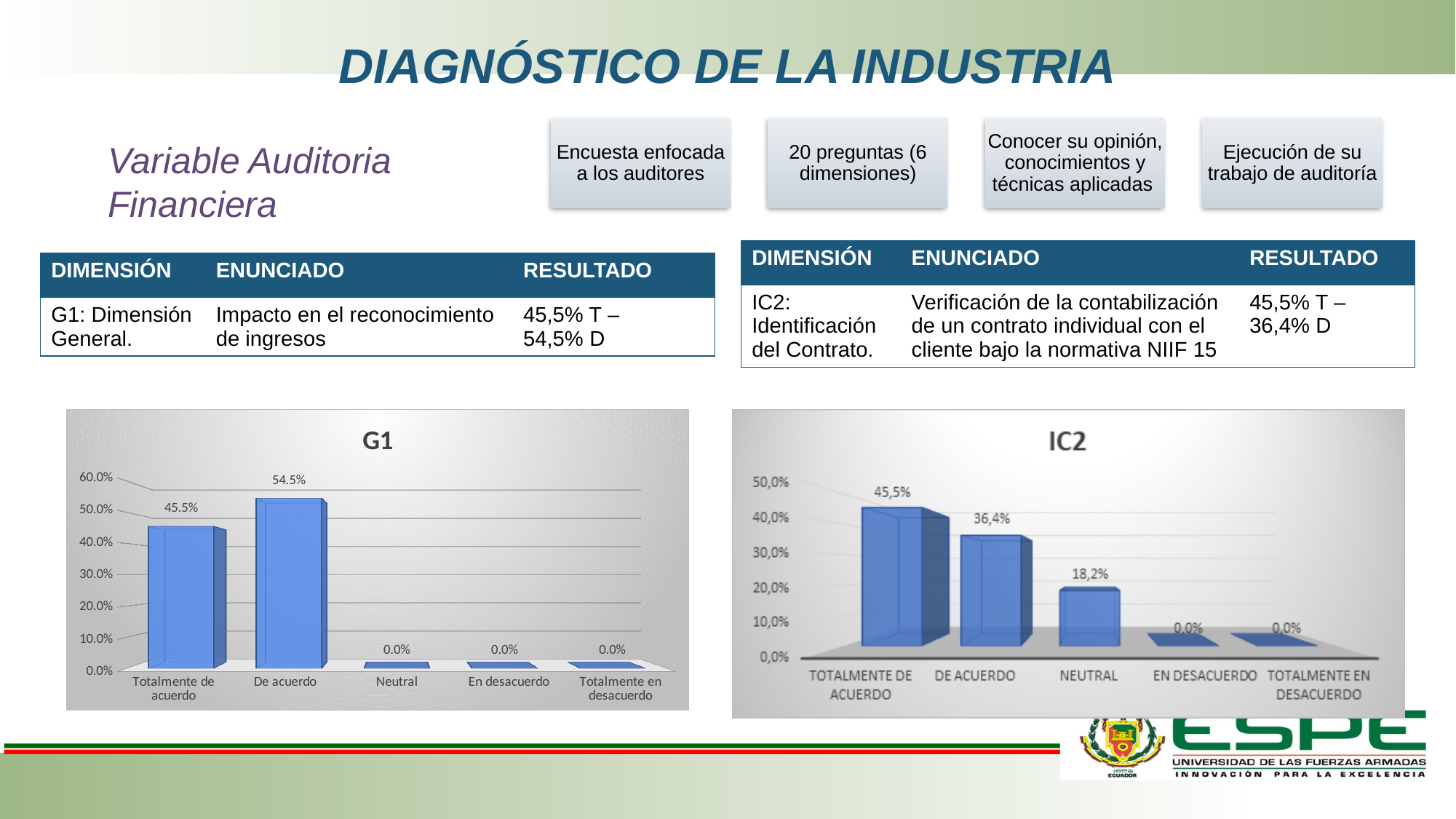
What kind of chart is the IC2 chart? Bar chart In the IC2 chart, which category has the highest value? TOTALMENTE DE ACUERDO In the IC2 chart, what is the difference between TOTALMENTE DE ACUERDO and DE ACUERDO? 9,1% In the IC2 chart, what is the value for NEUTRAL? 18,2% In the G1 chart, what is the difference between De acuerdo and Totalmente de acuerdo? 9.0% In the IC2 chart, what is the value for TOTALMENTE DE ACUERDO? 45,5% In the G1 chart, what is the value for Neutral? 0.0% In the G1 chart, what is the value for Totalmente de acuerdo? 45.5% In the IC2 chart, which is larger: DE ACUERDO or NEUTRAL? DE ACUERDO In the G1 chart, what is the value for De acuerdo? 54.5% In the G1 chart, which category has the highest value? De acuerdo In the G1 chart, how many categories are shown on the x axis? 5